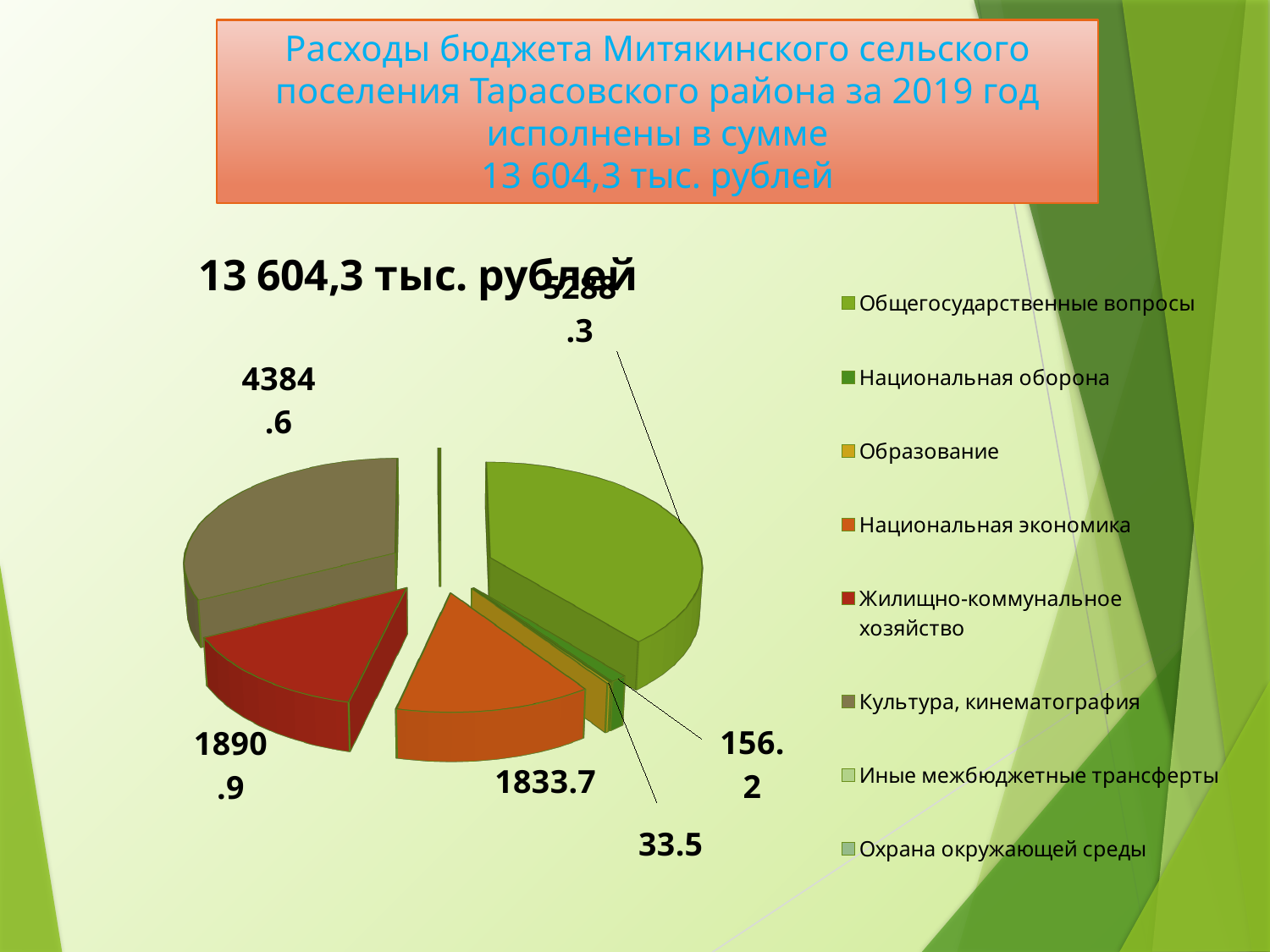
What is the difference between the values for Жилищно-коммунальное хозяйство and Национальная экономика? 57.2 Which is larger, the value for Жилищно-коммунальное хозяйство or the value for Национальная экономика? Жилищно-коммунальное хозяйство Which is larger, the value for Культура, кинематография or the value for Жилищно-коммунальное хозяйство? Культура, кинематография What is the value for Национальная экономика? 1833.7 What is the title of the chart? 13 604,3 тыс. рублей Which category has the largest slice of the pie? Общегосударственные вопросы How many categories does the chart legend list? 8 What is the value for Культура, кинематография? 4384.6 What is the value for Жилищно-коммунальное хозяйство? 1890.9 What kind of chart is shown on the slide? pie chart What is the difference between the values for Культура, кинематография and Национальная экономика? 2550.9 What colour is the slice for Жилищно-коммунальное хозяйство? red